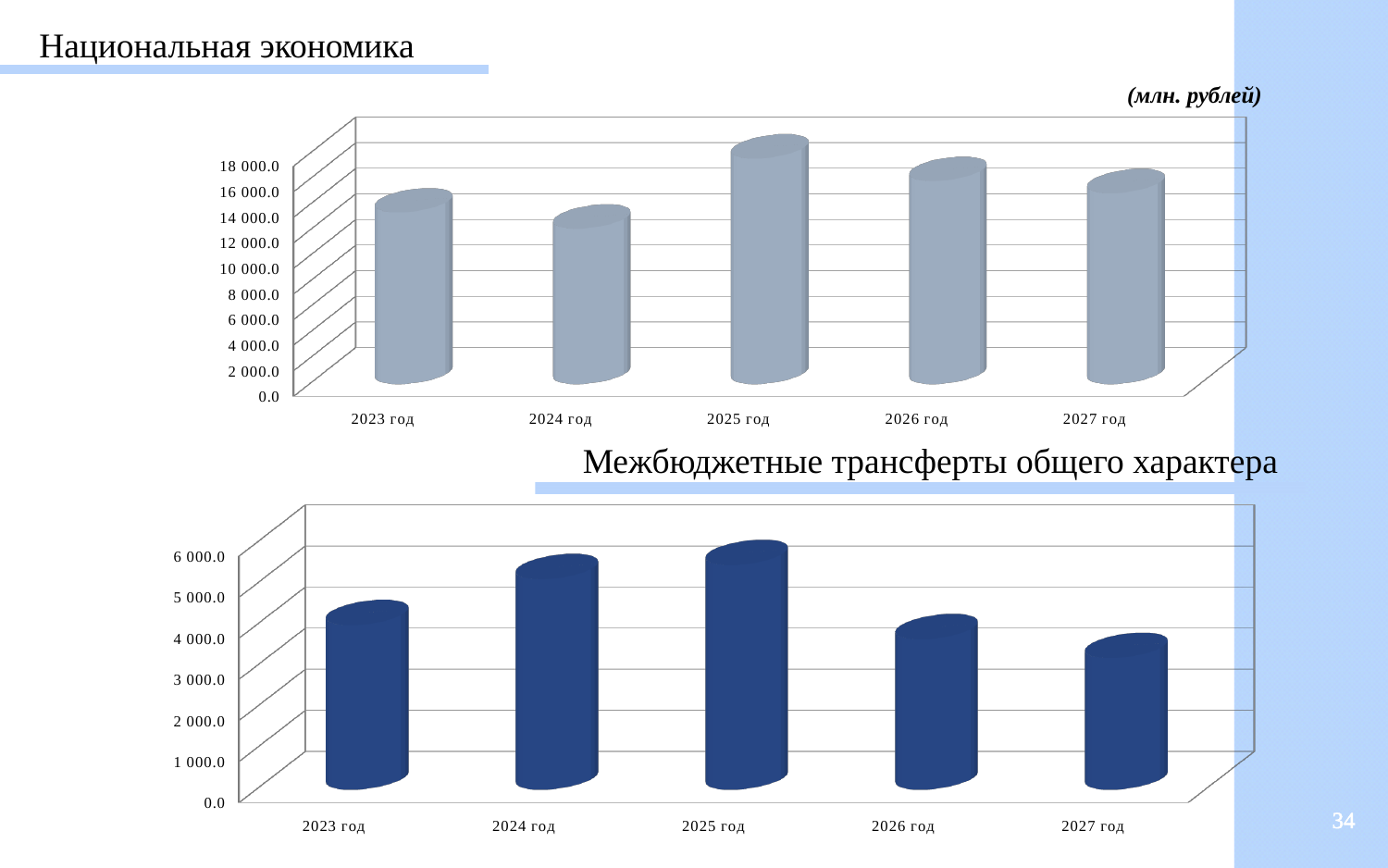
In the bottom chart (Межбюджетные трансферты общего характера), is the value for 2027 год greater or less than 5 000.0? less In the top chart (Национальная экономика), is the value for 2024 год greater or less than 16 000.0? less In the top chart (Национальная экономика), which year has the highest value? 2025 год In the top chart (Национальная экономика), which is larger, the value for 2023 год or the value for 2024 год? 2023 год In the bottom chart (Межбюджетные трансферты общего характера), which year has the lowest value? 2027 год In the top chart (Национальная экономика), how many years are shown on the x axis? 5 In the bottom chart (Межбюджетные трансферты общего характера), is the value for 2025 год greater or less than 4 000.0? greater In the top chart (Национальная экономика), which year has the lowest value? 2024 год What kind of chart is the bottom chart (Межбюджетные трансферты общего характера)? bar chart In the bottom chart (Межбюджетные трансферты общего характера), do the values rise or fall from 2025 год to 2027 год? fall In the bottom chart (Межбюджетные трансферты общего характера), which is larger, the value for 2024 год or the value for 2023 год? 2024 год